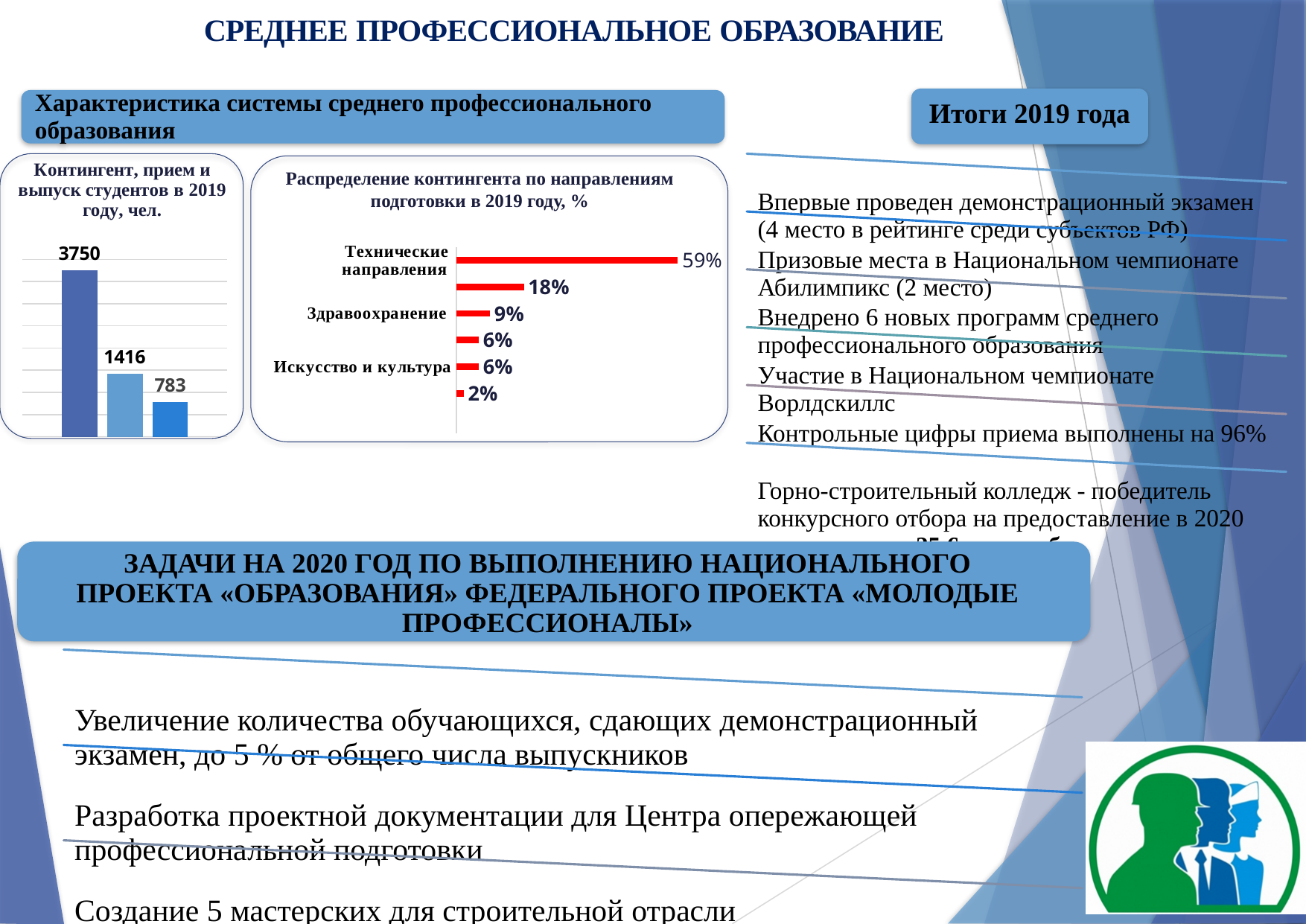
In the chart 'Распределение контингента по направлениям подготовки в 2019 году, %', how many bars are plotted? 6 In the chart 'Контингент, прием и выпуск студентов в 2019 году, чел.', what is the value of the tallest bar? 3750 In the chart 'Распределение контингента по направлениям подготовки в 2019 году, %', which category has the highest value? Технические направления In the chart 'Контингент, прием и выпуск студентов в 2019 году, чел.', what is the value of the middle bar? 1416 What type of chart is 'Контингент, прием и выпуск студентов в 2019 году, чел.'? bar chart In the chart 'Контингент, прием и выпуск студентов в 2019 году, чел.', what is the value of the shortest bar? 783 In the chart 'Контингент, прием и выпуск студентов в 2019 году, чел.', what is the difference between the first bar and the second bar? 2334 In the chart 'Распределение контингента по направлениям подготовки в 2019 году, %', what is the value for Здравоохранение? 9% In the chart 'Распределение контингента по направлениям подготовки в 2019 году, %', what is the value for Технические направления? 59% In the chart 'Распределение контингента по направлениям подготовки в 2019 году, %', what is the smallest value shown? 2% In the chart 'Контингент, прием и выпуск студентов в 2019 году, чел.', how many bars are plotted? 3 In the chart 'Распределение контингента по направлениям подготовки в 2019 году, %', what is the value for Искусство и культура? 6%